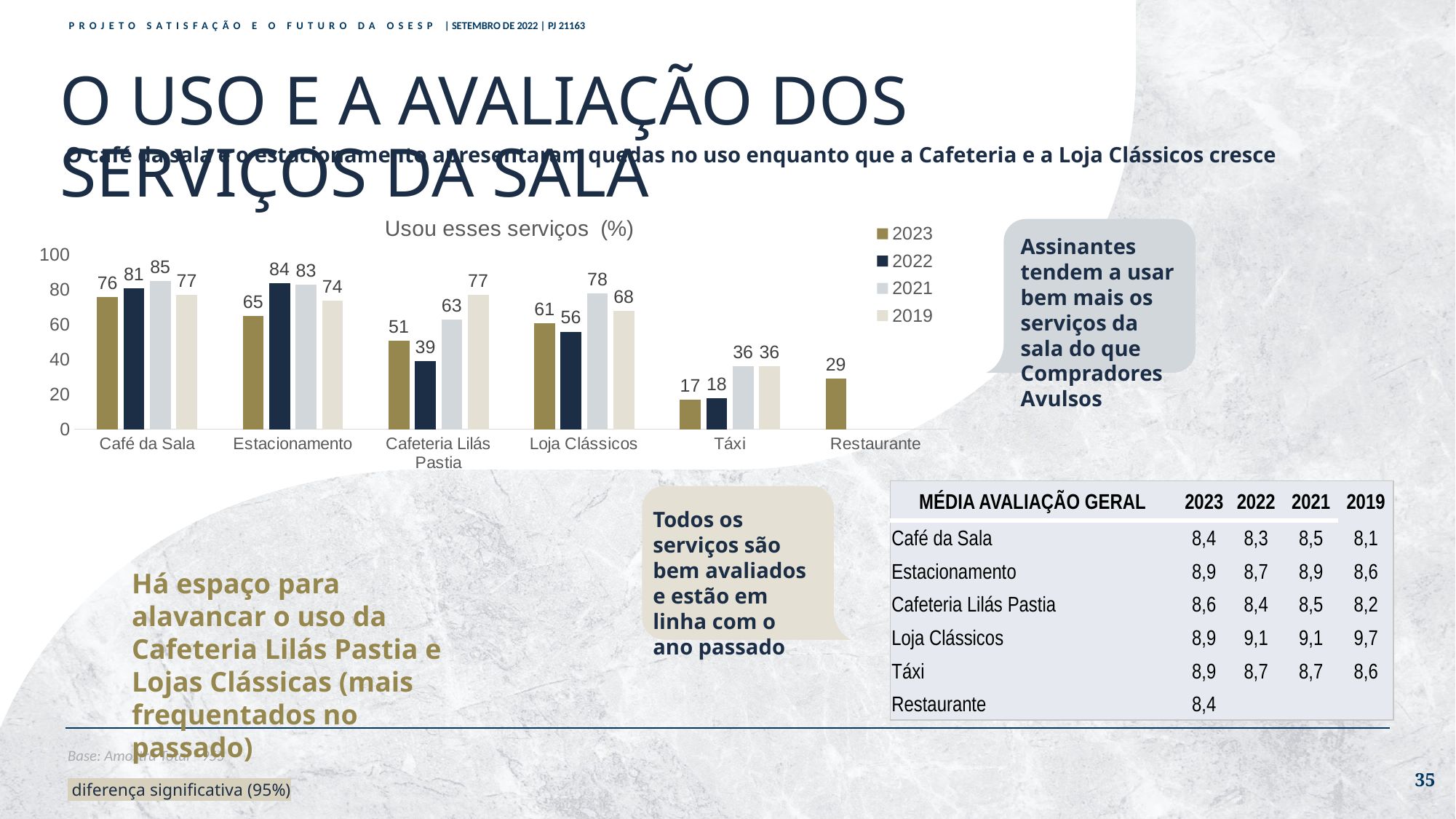
What is the value for Café da Sala in the 2023 series? 76 Which category has the highest value in the 2022 series? Estacionamento How many series does the legend list? 4 How many categories are shown on the x axis? 6 What is the value for Cafeteria Lilás Pastia in the 2019 series? 77 Which category has the lowest value in the 2023 series? Táxi Which category has a value only for the 2023 series? Restaurante What is the value for Táxi in the 2021 series? 36 Which is larger for Loja Clássicos: the 2023 value or the 2022 value? 2023 What is the difference between the 2021 and 2022 values for Cafeteria Lilás Pastia? 24 What kind of chart is shown on the slide? Bar chart What is the title of the chart? Usou esses serviços (%)